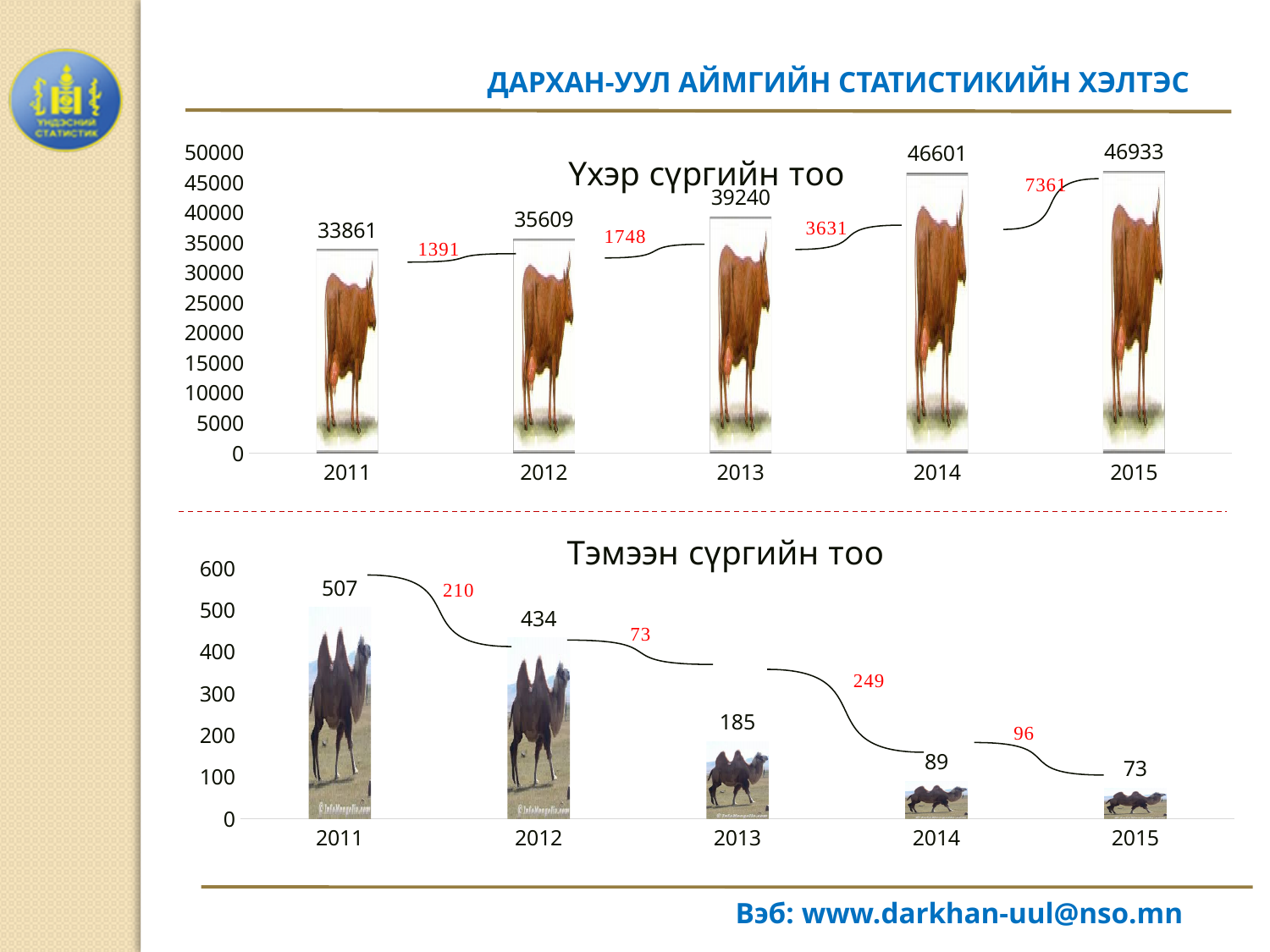
In the chart titled "Тэмээн сүргийн тоо", do the values rise or fall from 2011 to 2015? fall In the chart titled "Үхэр сүргийн тоо", which year has the lowest value? 2011 In the chart titled "Тэмээн сүргийн тоо", which year has the highest value? 2011 In the chart titled "Үхэр сүргийн тоо", what is the difference between the values for 2014 and 2013? 7361 In the chart titled "Тэмээн сүргийн тоо", what is the difference between the values for 2012 and 2013? 249 In the chart titled "Үхэр сүргийн тоо", do the values rise or fall from 2011 to 2015? rise What kind of chart is the chart titled "Тэмээн сүргийн тоо"? bar chart In the chart titled "Үхэр сүргийн тоо", which year has the highest value? 2015 In the chart titled "Үхэр сүргийн тоо", how many years are shown on the x axis? 5 In the chart titled "Үхэр сүргийн тоо", what is the value for 2013? 39240 In the chart titled "Тэмээн сүргийн тоо", what is the value for 2014? 89 In the chart titled "Тэмээн сүргийн тоо", is the value for 2012 larger or smaller than the value for 2013? larger